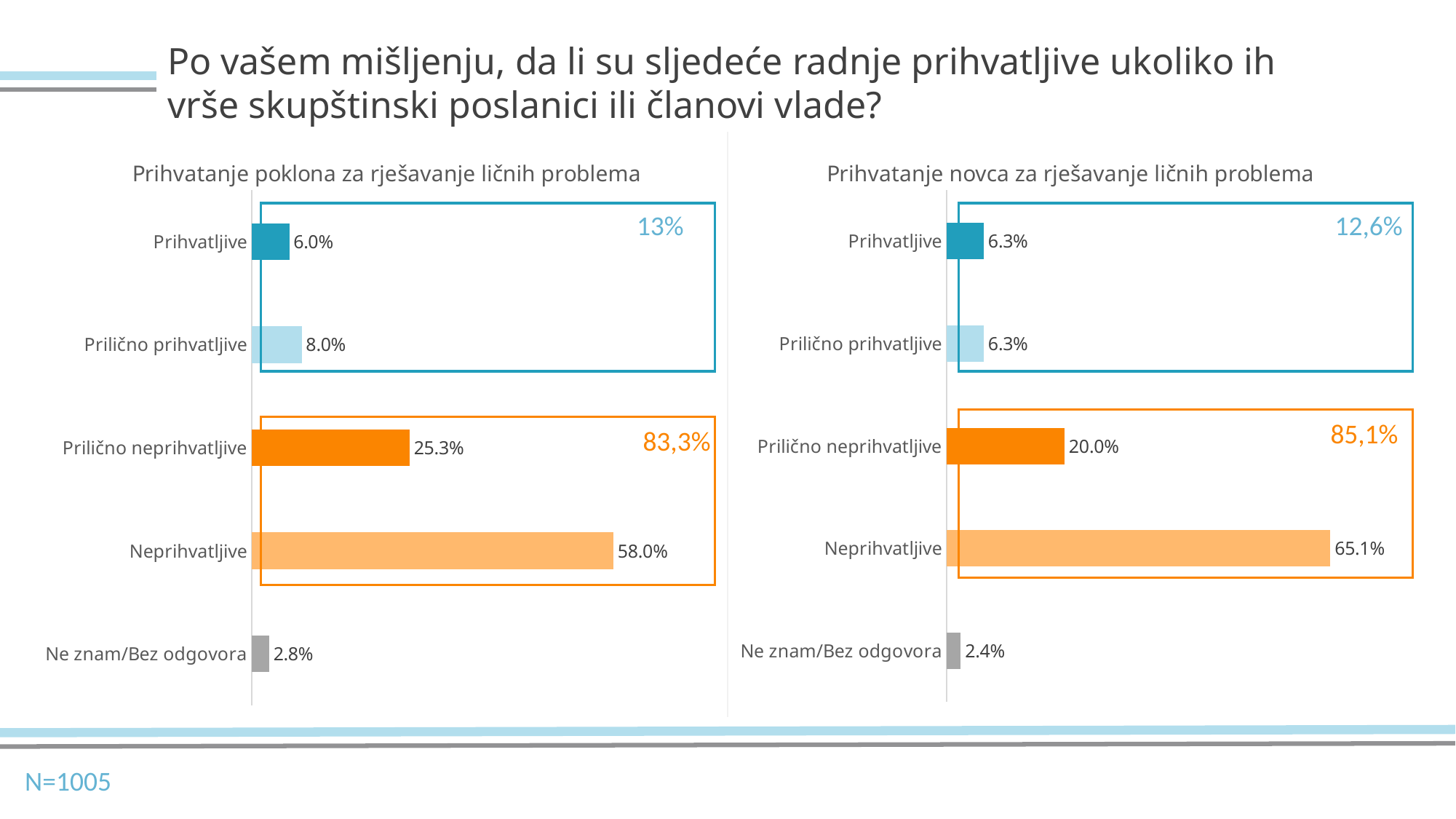
In the chart titled "Prihvatanje novca za rješavanje ličnih problema", what is the value for Prilično neprihvatljive? 20.0% In the chart titled "Prihvatanje poklona za rješavanje ličnih problema", what combined percentage is shown in the orange box for the unacceptable categories? 83,3% In the chart titled "Prihvatanje novca za rješavanje ličnih problema", what is the value for Ne znam/Bez odgovora? 2.4% What type of chart is used on the left side of the slide (Prihvatanje poklona za rješavanje ličnih problema)? Bar chart In the chart titled "Prihvatanje poklona za rješavanje ličnih problema", what is the difference between Neprihvatljive and Prilično neprihvatljive? 32.7% In the chart titled "Prihvatanje novca za rješavanje ličnih problema", which category has the lowest value? Ne znam/Bez odgovora In the chart titled "Prihvatanje poklona za rješavanje ličnih problema", what is the value for Prilično prihvatljive? 8.0% Which is larger: Prilično neprihvatljive in the left chart (Prihvatanje poklona) or Prilično neprihvatljive in the right chart (Prihvatanje novca)? Left chart (Prihvatanje poklona), 25.3% In the chart titled "Prihvatanje poklona za rješavanje ličnih problema", which category has the highest value? Neprihvatljive In the chart titled "Prihvatanje poklona za rješavanje ličnih problema", what is the value for Neprihvatljive? 58.0% How many categories are shown in the chart titled "Prihvatanje novca za rješavanje ličnih problema"? 5 In the chart titled "Prihvatanje novca za rješavanje ličnih problema", what is the difference between Neprihvatljive and Prihvatljive? 58.8%